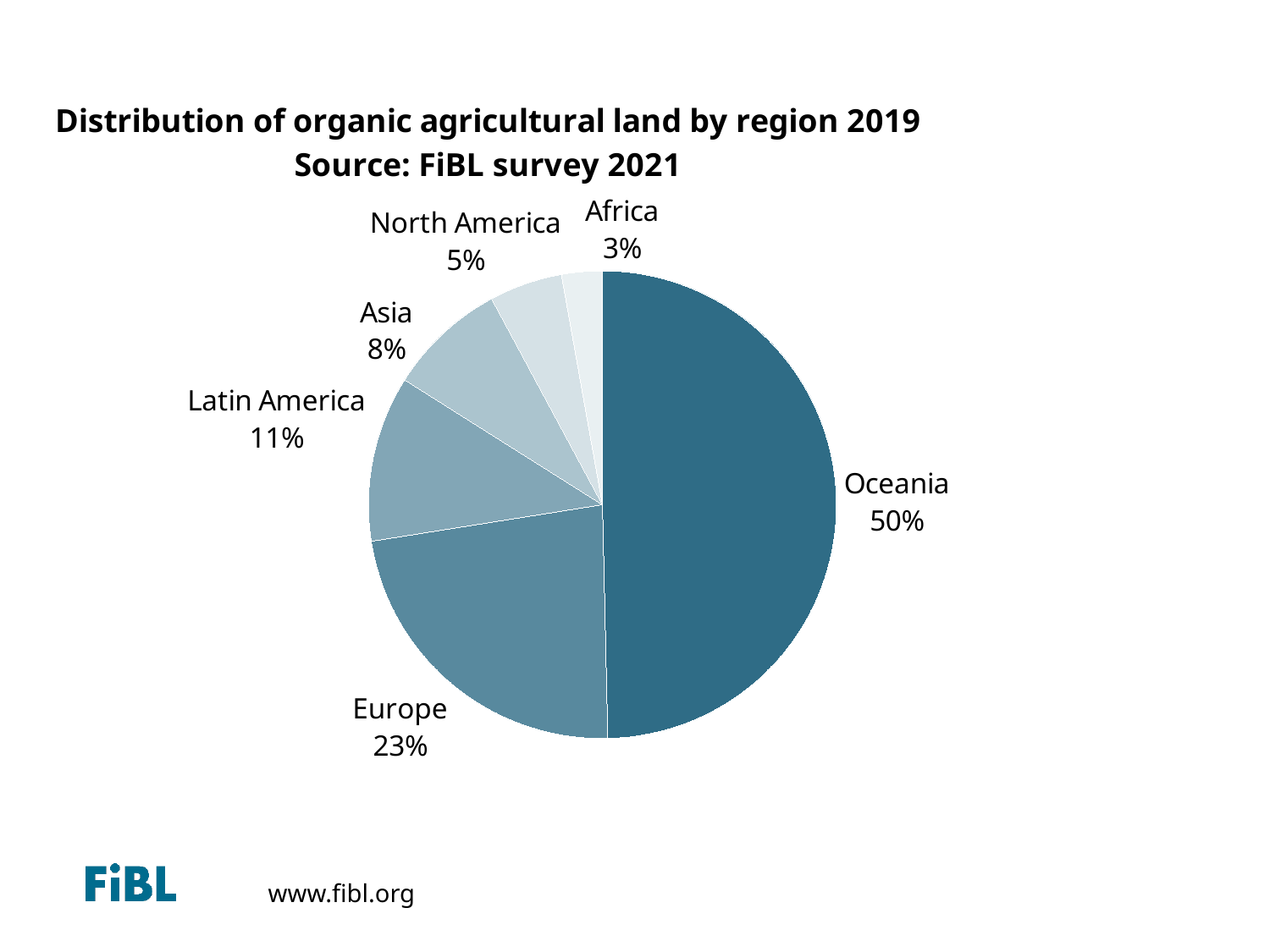
What share of organic agricultural land does North America hold? 5% How many regions are shown in the pie chart? 6 Which has a larger share, Latin America or Asia? Latin America What share of organic agricultural land does Oceania hold? 50% What share of organic agricultural land does Asia hold? 8% What share of organic agricultural land does Latin America hold? 11% Which region has the smallest share of organic agricultural land? Africa What type of chart is shown on the slide? Pie chart What is the title of the chart? Distribution of organic agricultural land by region 2019 What share of organic agricultural land does Europe hold? 23% Which region has the largest share of organic agricultural land? Oceania What is the difference in percentage points between Oceania's share and Europe's share? 27